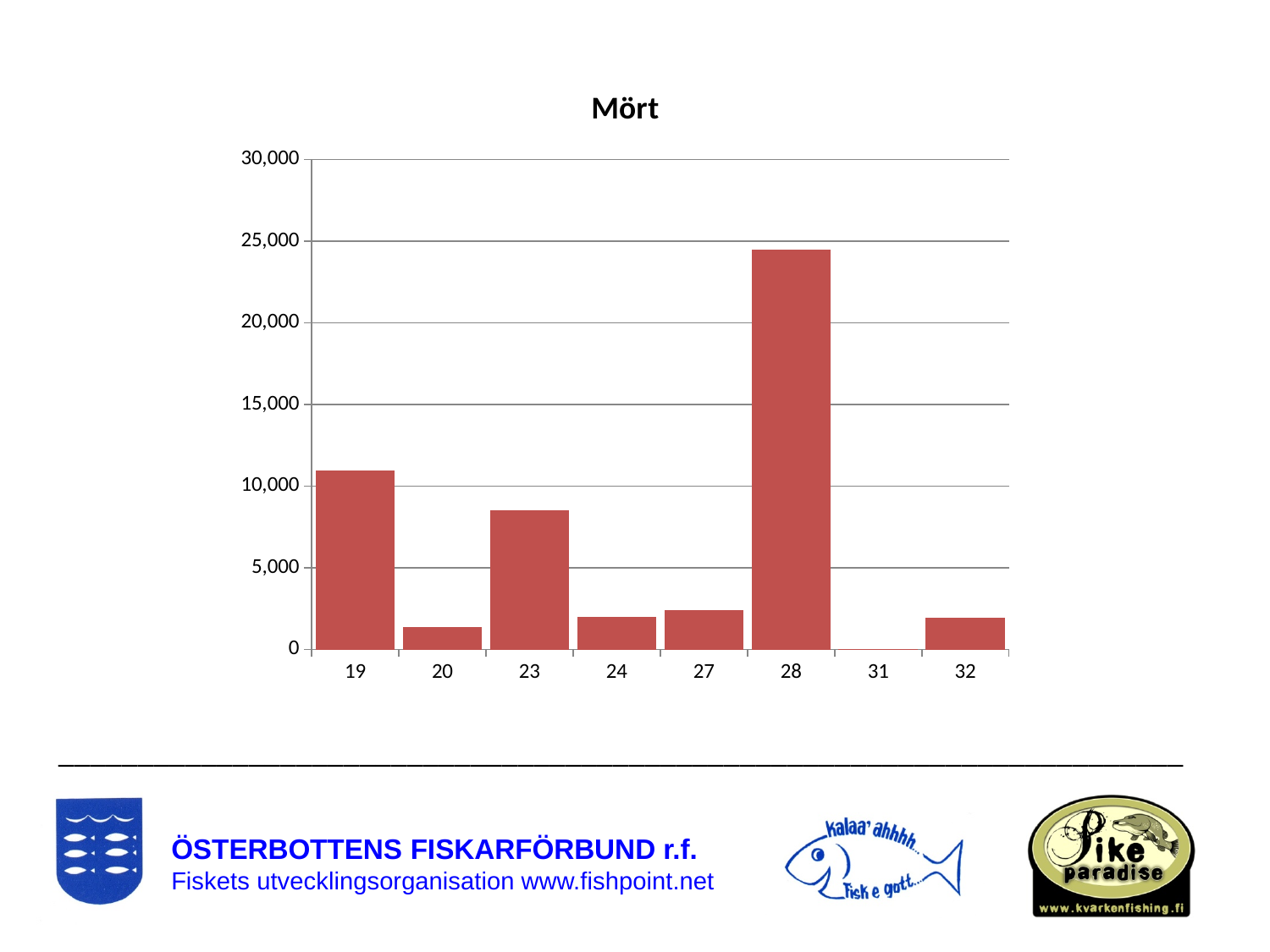
Which has a larger value, category 20 or category 27? 27 Is the value for category 23 greater or less than 10,000? less Is the value for category 28 greater or less than 20,000? greater How many categories are shown on the x axis of the chart? 8 Is the value for category 27 greater or less than 5,000? less What is the title of the chart? Mört Which category has the highest value in the chart? 28 What is the highest value shown on the y axis of the chart? 30,000 Which has a larger value, category 19 or category 23? 19 What kind of chart is shown on the slide? bar chart Which category has the lowest value in the chart? 31